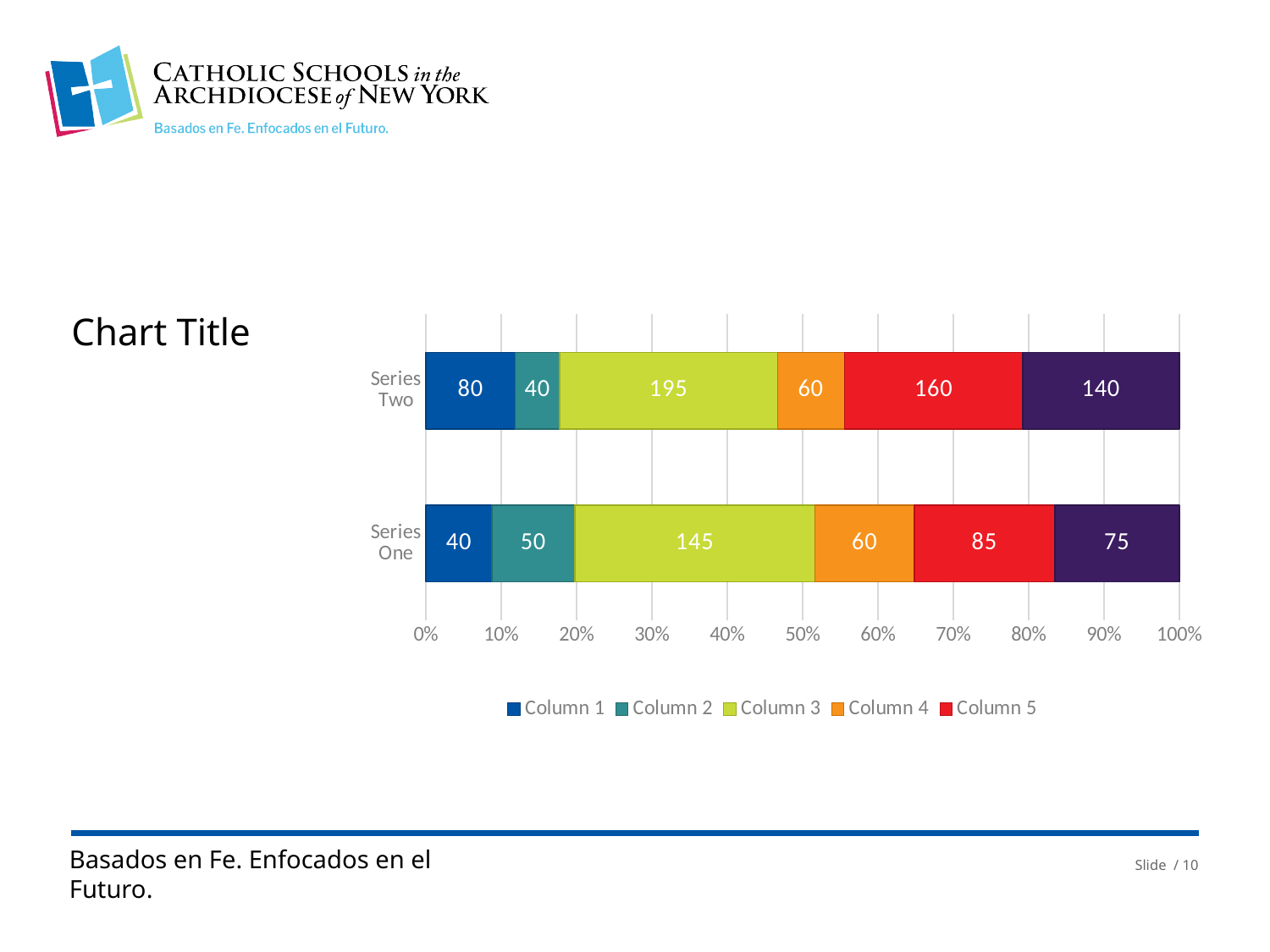
What is the total of all segments in the Series Two bar? 675 What is the total of all segments in the Series One bar? 455 Which has the larger Column 2 value, Series One or Series Two? Series One How many series does the legend list? 5 What is the value of Column 3 for Series Two? 195 What is the difference between the Column 5 values for Series Two and Series One? 75 What type of chart is shown on the slide? Stacked bar chart What is the difference between the Column 3 values for Series Two and Series One? 50 Which has the larger Column 1 value, Series One or Series Two? Series Two What is the value of Column 2 for Series One? 50 What is the value of Column 1 for Series One? 40 What is the value of Column 5 for Series Two? 160